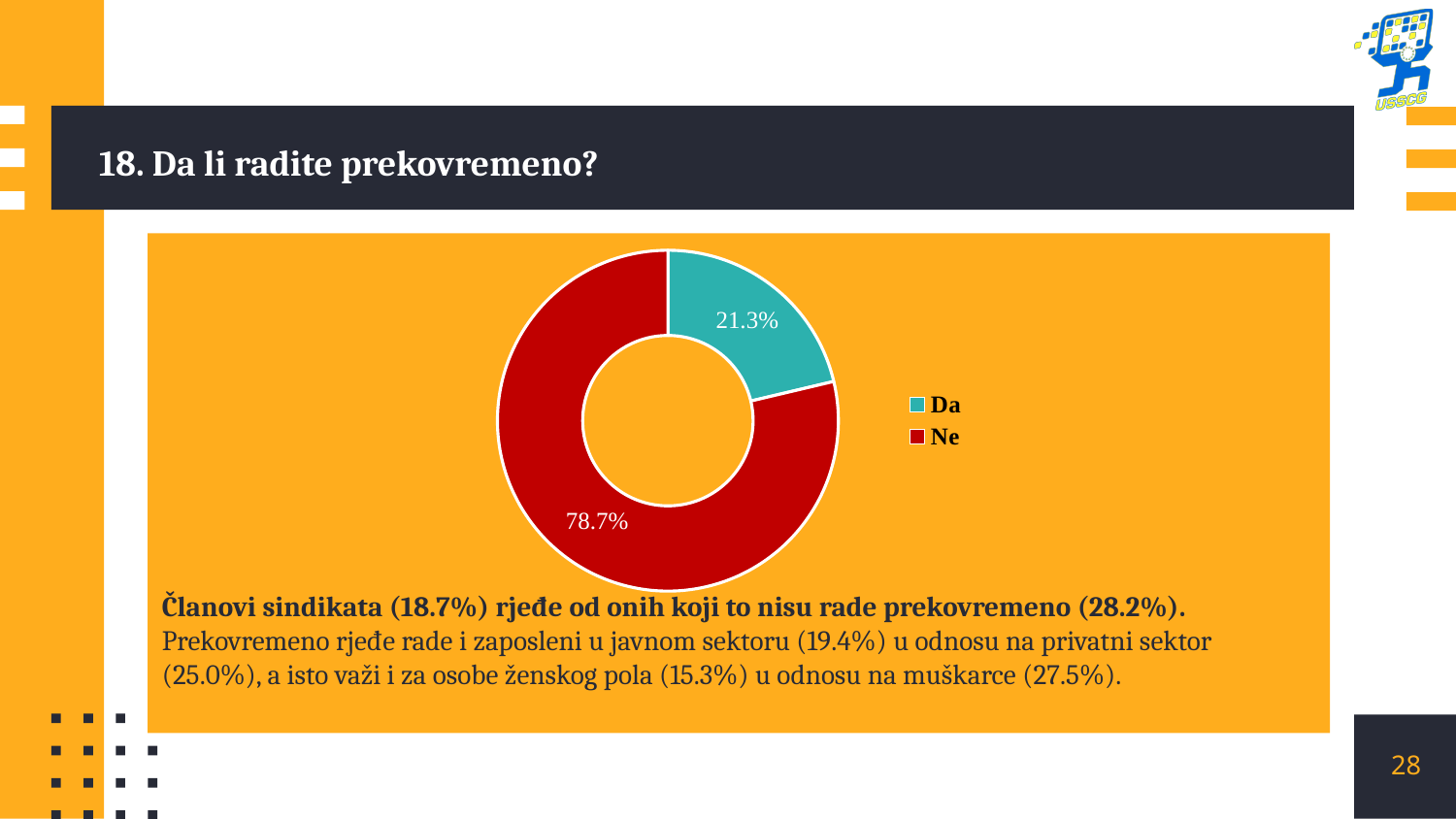
Which category has the largest share of the chart? Ne Which category has the smallest share of the chart? Da What colour is the "Ne" slice? Red How many categories does the chart show? 2 What is the title of the slide containing the chart? 18. Da li radite prekovremeno? What share of the chart does the "Da" slice represent? 21.3% What kind of chart is shown on the slide? Doughnut (pie) chart Which is larger, the share for "Da" or the share for "Ne"? Ne What is the difference in percentage points between the "Ne" and "Da" slices? 57.4 What percentage of respondents answered "Ne" (no)? 78.7% How many entries does the legend list? 2 What percentage of respondents answered "Da" (yes) to working overtime? 21.3%